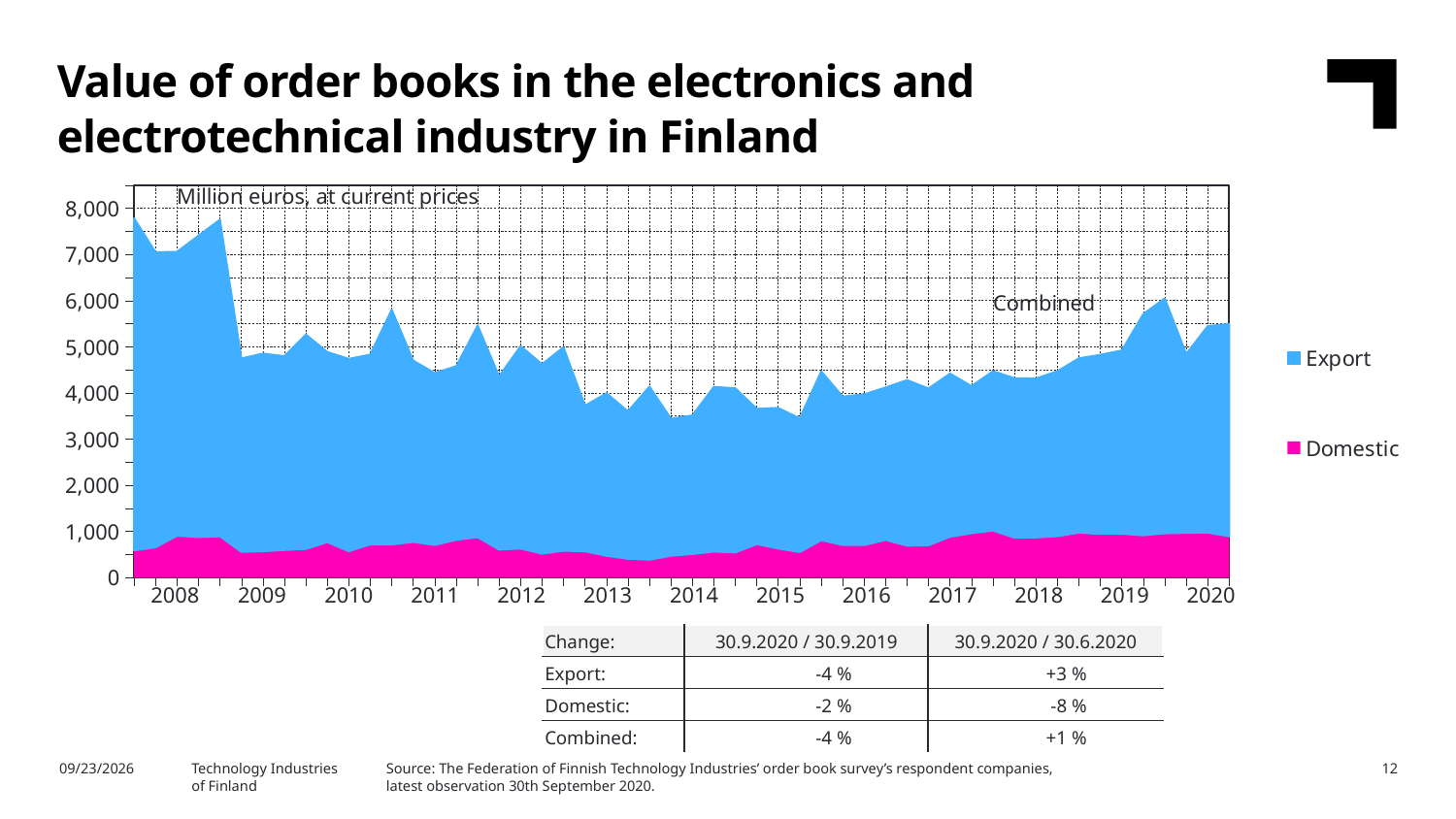
How many year labels are shown on the x axis? 13 What unit is stated for the values on the chart? Million euros, at current prices Does the combined value rise or fall between 2017 and 2020? rise What kind of chart is shown on the slide? Area chart Which two series are listed in the legend? Export and Domestic Is the combined value at the end of 2020 greater or less than 5,000? greater Is the Domestic value in 2018 greater or less than 2,000? less Does the combined value rise or fall between 2008 and 2014? fall Is the combined value at the start of 2008 greater or less than 7,000? greater How many series does the legend list? 2 Which series accounts for the larger part of the combined order book value, Export or Domestic? Export